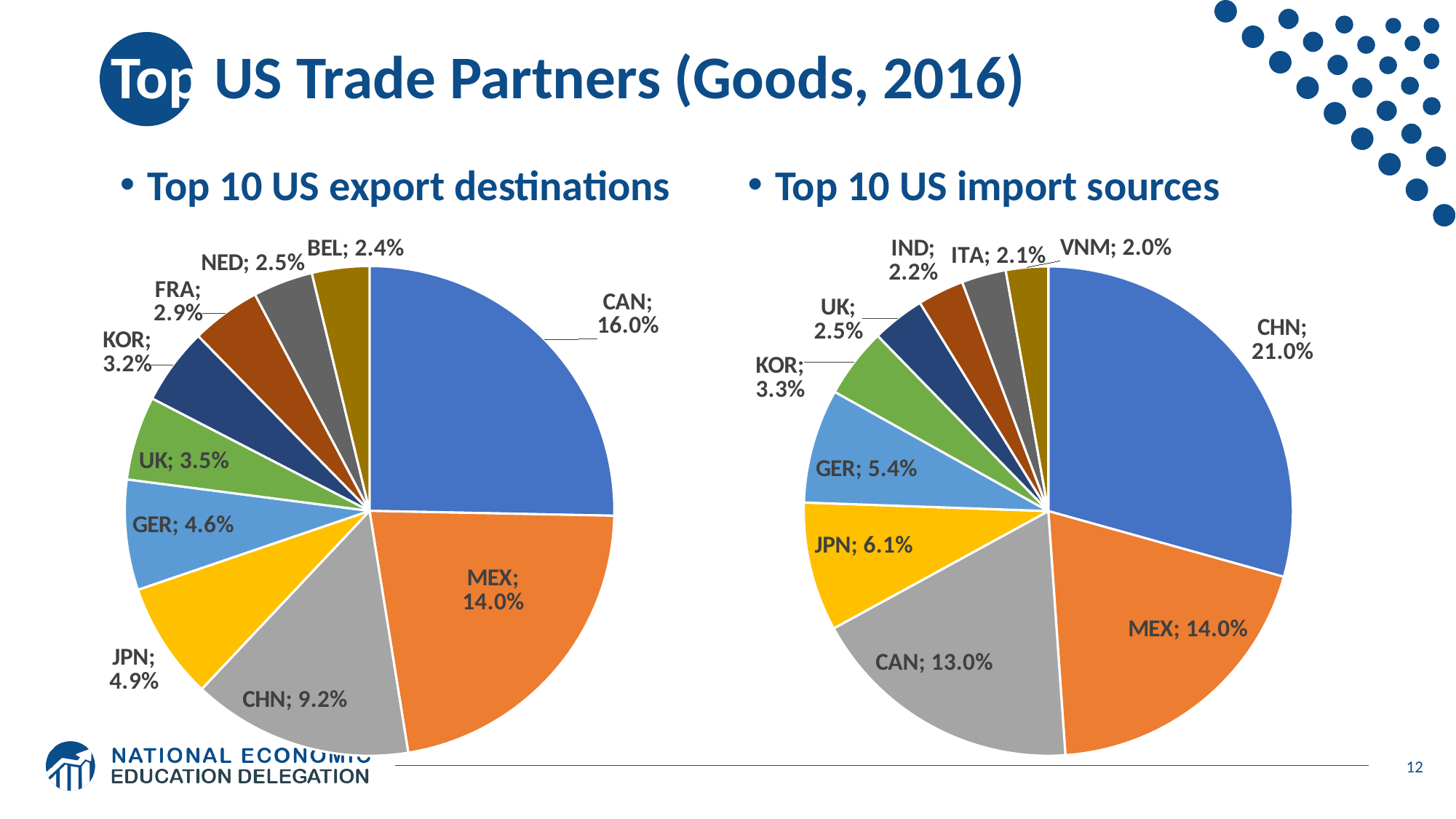
What is the title of the slide? Top US Trade Partners (Goods, 2016) In the Top 10 US export destinations pie chart, what is the difference between the shares of CAN and MEX? 2.0% In the Top 10 US export destinations pie chart, which country has the largest share? CAN How many slices does the Top 10 US export destinations pie chart have? 10 In the Top 10 US import sources pie chart, which country has the smallest share? VNM What kind of chart is used for the Top 10 US import sources? Pie chart In the Top 10 US export destinations pie chart, what share does JPN have? 4.9% In the Top 10 US export destinations pie chart, what share does CAN have? 16.0% In the Top 10 US import sources pie chart, which is larger, the share of JPN or the share of GER? JPN In the Top 10 US export destinations pie chart, which country has the smallest share? BEL In the Top 10 US import sources pie chart, what share does CHN have? 21.0% In the Top 10 US import sources pie chart, what is the difference between the shares of CHN and CAN? 8.0%